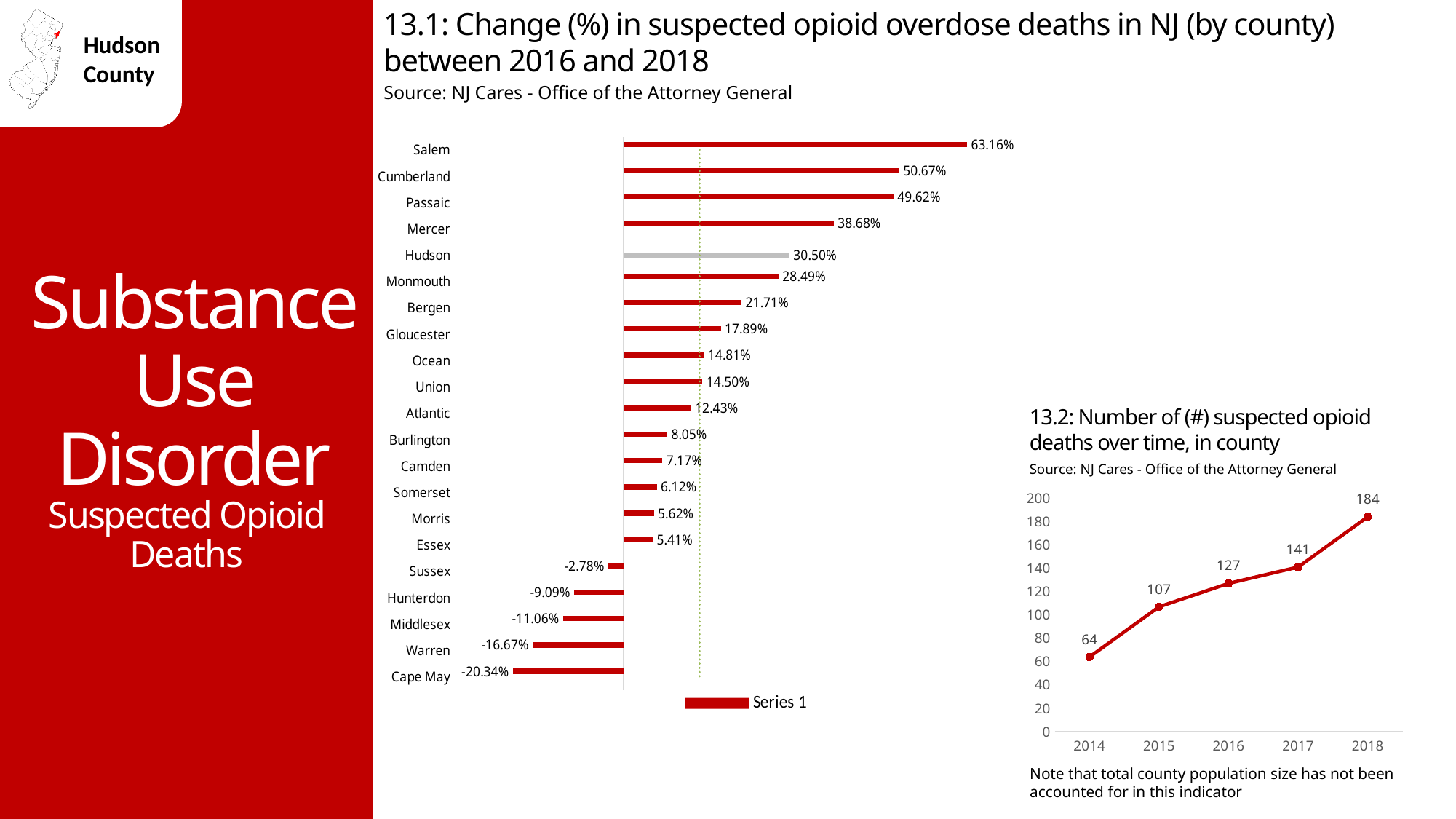
What is the legend entry shown in chart 13.1? Series 1 In chart 13.1, what is the change (%) in suspected opioid overdose deaths for Hudson County? 30.50% In chart 13.1, which has a larger change (%): Bergen or Monmouth? Monmouth In chart 13.1, what is the value shown for Passaic? 49.62% In chart 13.2, how many years are plotted? 5 In chart 13.1, which county has the lowest change (%) in suspected opioid overdose deaths? Cape May In chart 13.2, do the number of suspected opioid deaths rise or fall from 2014 to 2018? Rise In chart 13.2, how many suspected opioid deaths were there in 2016? 127 What kind of chart is chart 13.1? Bar chart In chart 13.2, what is the difference in suspected opioid deaths between 2018 and 2014? 120 In chart 13.1, which county has the highest change (%) in suspected opioid overdose deaths? Salem In chart 13.1, how many counties are plotted? 21